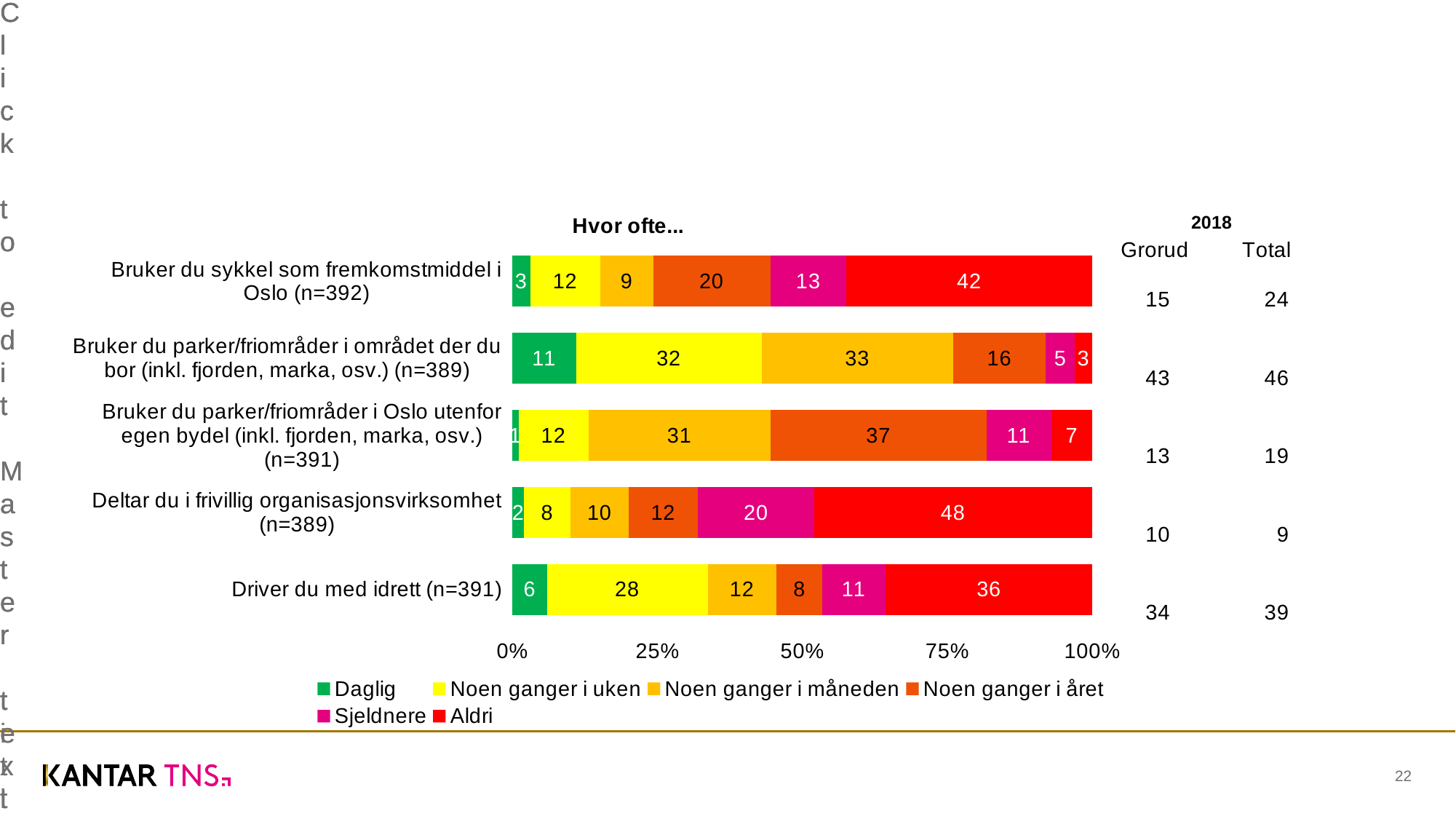
Which is larger: the 'Sjeldnere' value for 'Deltar du i frivillig organisasjonsvirksomhet (n=389)' or for 'Driver du med idrett (n=391)'? Deltar du i frivillig organisasjonsvirksomhet (n=389) What is the 'Aldri' value for 'Bruker du sykkel som fremkomstmiddel i Oslo (n=392)'? 42 What is the title of the chart? Hvor ofte... What is the difference between the 'Noen ganger i uken' values for 'Driver du med idrett (n=391)' and 'Bruker du sykkel som fremkomstmiddel i Oslo (n=392)'? 16 Which category has the lowest 'Daglig' value? Bruker du parker/friområder i Oslo utenfor egen bydel (inkl. fjorden, marka, osv.) (n=391) What is the 'Noen ganger i måneden' value for 'Bruker du parker/friområder i området der du bor (inkl. fjorden, marka, osv.) (n=389)'? 33 What is the 'Daglig' value for 'Driver du med idrett (n=391)'? 6 How many categories (questions) are shown in the chart? 5 How many series does the legend list? 6 Which category has the highest 'Aldri' value? Deltar du i frivillig organisasjonsvirksomhet (n=389) What is the total of the stacked bar for 'Bruker du parker/friområder i området der du bor (inkl. fjorden, marka, osv.) (n=389)'? 100 What kind of chart is shown on the slide? Stacked bar chart